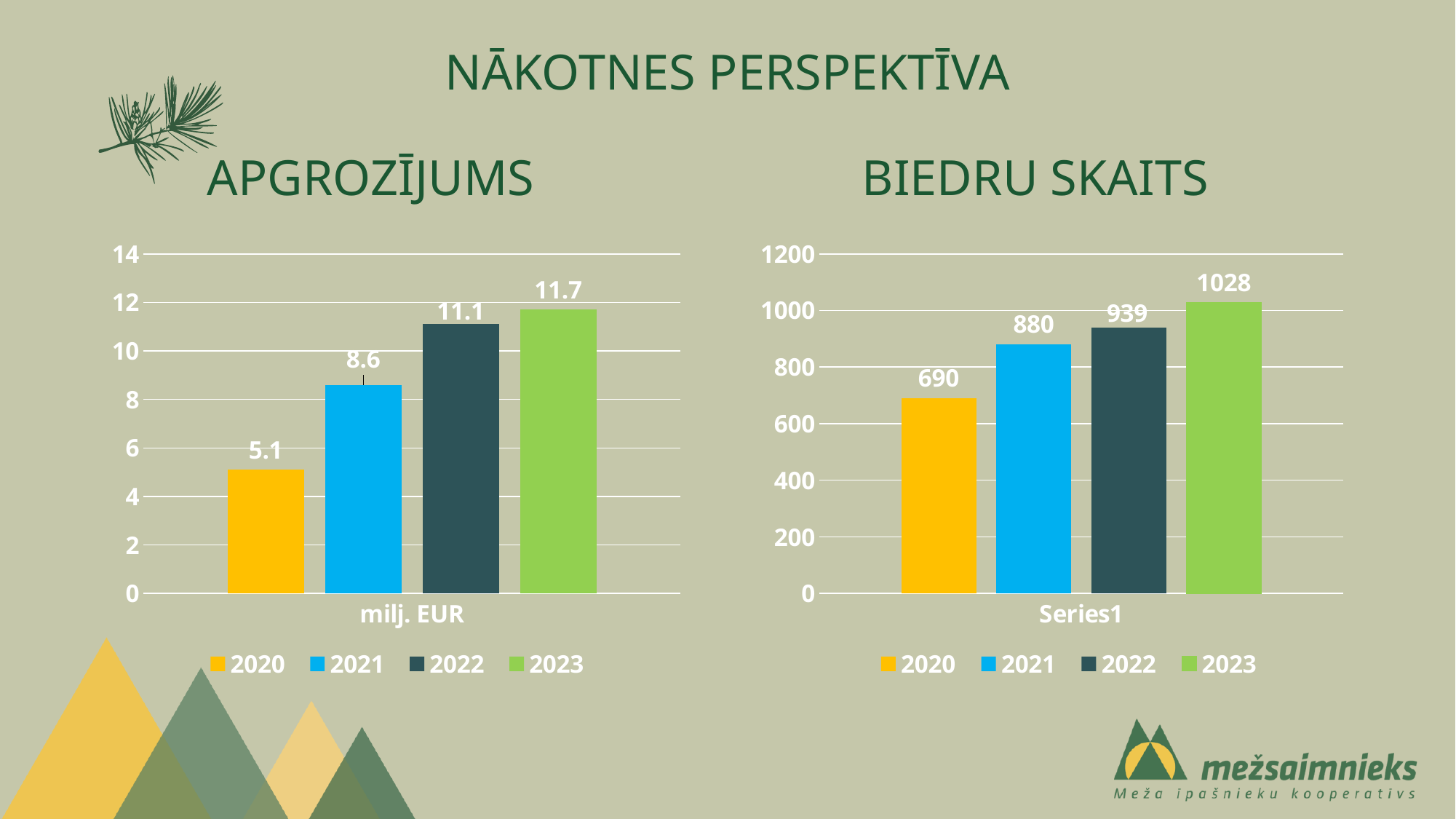
In the BIEDRU SKAITS chart, which is larger, the value for 2021 or the value for 2022? 2022 What kind of chart is the APGROZĪJUMS chart? bar chart In the APGROZĪJUMS chart, what is the value for 2023? 11.7 In the BIEDRU SKAITS chart, what is the difference between the values for 2023 and 2021? 148 In the BIEDRU SKAITS chart, what is the value for 2022? 939 In the BIEDRU SKAITS chart, which year has the highest value? 2023 In the APGROZĪJUMS chart, do the values rise or fall from 2020 to 2023? rise In the APGROZĪJUMS chart, what is the difference between the values for 2022 and 2020? 6.0 How many series does the legend of the BIEDRU SKAITS chart list? 4 In the APGROZĪJUMS chart, what is the value for 2021? 8.6 In the BIEDRU SKAITS chart, what is the value for 2020? 690 In the APGROZĪJUMS chart, which year has the lowest value? 2020